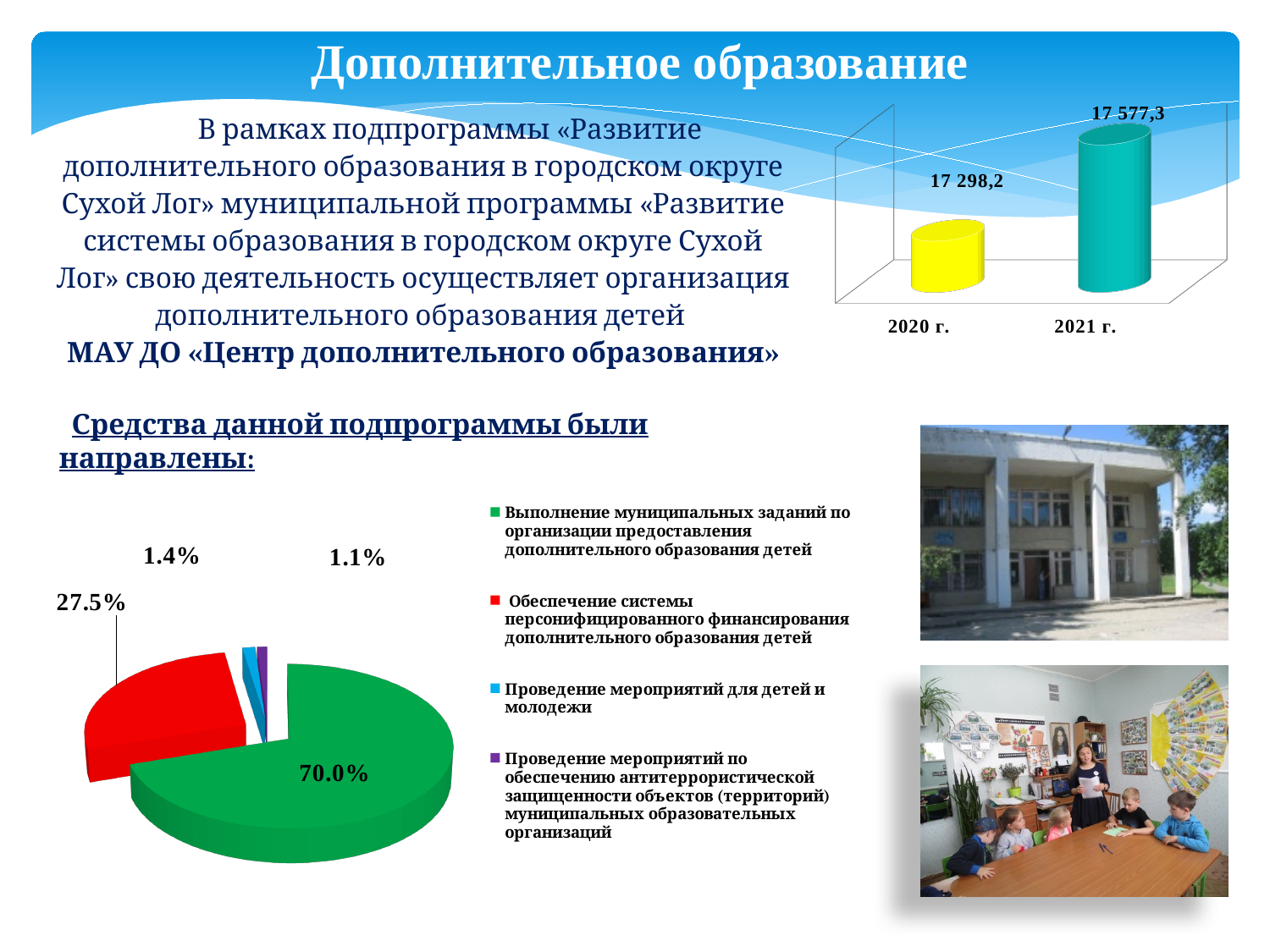
In the bar chart at the top right, do the values rise or fall from 2020 г. to 2021 г.? Rise In the bar chart at the top right, what is the difference between the 2021 г. and 2020 г. values? 279,1 In the bar chart at the top right, which year has the higher value? 2021 г. In the bar chart at the top right, what is the value for 2021 г.? 17 577,3 In the pie chart at the bottom left, what colour is the slice for 'Проведение мероприятий для детей и молодежи'? Blue In the bar chart at the top right, how many bars are plotted? 2 In the pie chart at the bottom left, what share is shown for 'Обеспечение системы персонифицированного финансирования дополнительного образования детей'? 27.5% In the bar chart at the top right, what is the value for 2020 г.? 17 298,2 What kind of chart is shown at the top right of the slide? Bar chart In the pie chart at the bottom left, what share is shown for 'Выполнение муниципальных заданий по организации предоставления дополнительного образования детей'? 70.0% In the pie chart at the bottom left, which category has the smallest share? Проведение мероприятий по обеспечению антитеррористической защищенности объектов (территорий) муниципальных образовательных организаций How many entries does the legend of the pie chart at the bottom left list? 4